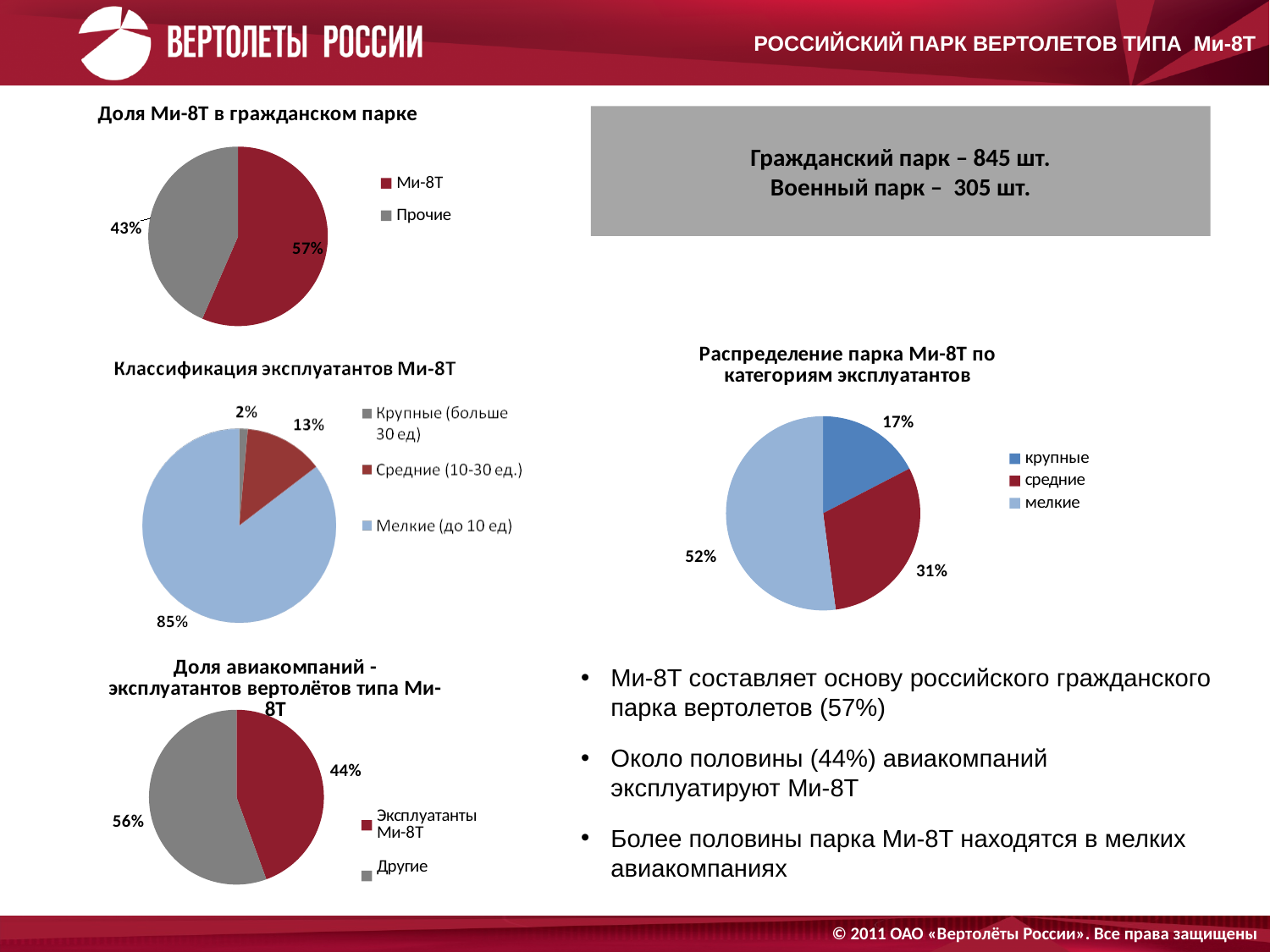
In the chart 'Распределение парка Ми-8Т по категориям эксплуатантов', what share do средние have? 31% In the chart 'Доля Ми-8Т в гражданском парке', what share does Прочие have? 43% In the chart 'Распределение парка Ми-8Т по категориям эксплуатантов', which category has the largest share? мелкие In the chart 'Распределение парка Ми-8Т по категориям эксплуатантов', what is the difference between the shares of мелкие and крупные? 35% In the chart 'Доля Ми-8Т в гражданском парке', what share does Ми-8Т have? 57% In the chart 'Классификация эксплуатантов Ми-8Т', which category has the smallest share? Крупные (больше 30 ед) In the chart 'Доля авиакомпаний - эксплуатантов вертолётов типа Ми-8Т', what share do Эксплуатанты Ми-8Т have? 44% What kind of chart is 'Доля Ми-8Т в гражданском парке'? Pie chart In the chart 'Доля авиакомпаний - эксплуатантов вертолётов типа Ми-8Т', which is larger: Эксплуатанты Ми-8Т or Другие? Другие In the chart 'Классификация эксплуатантов Ми-8Т', what share do Мелкие (до 10 ед) have? 85% How many categories does the legend of 'Классификация эксплуатантов Ми-8Т' list? 3 How many pie charts are shown on the slide? 4